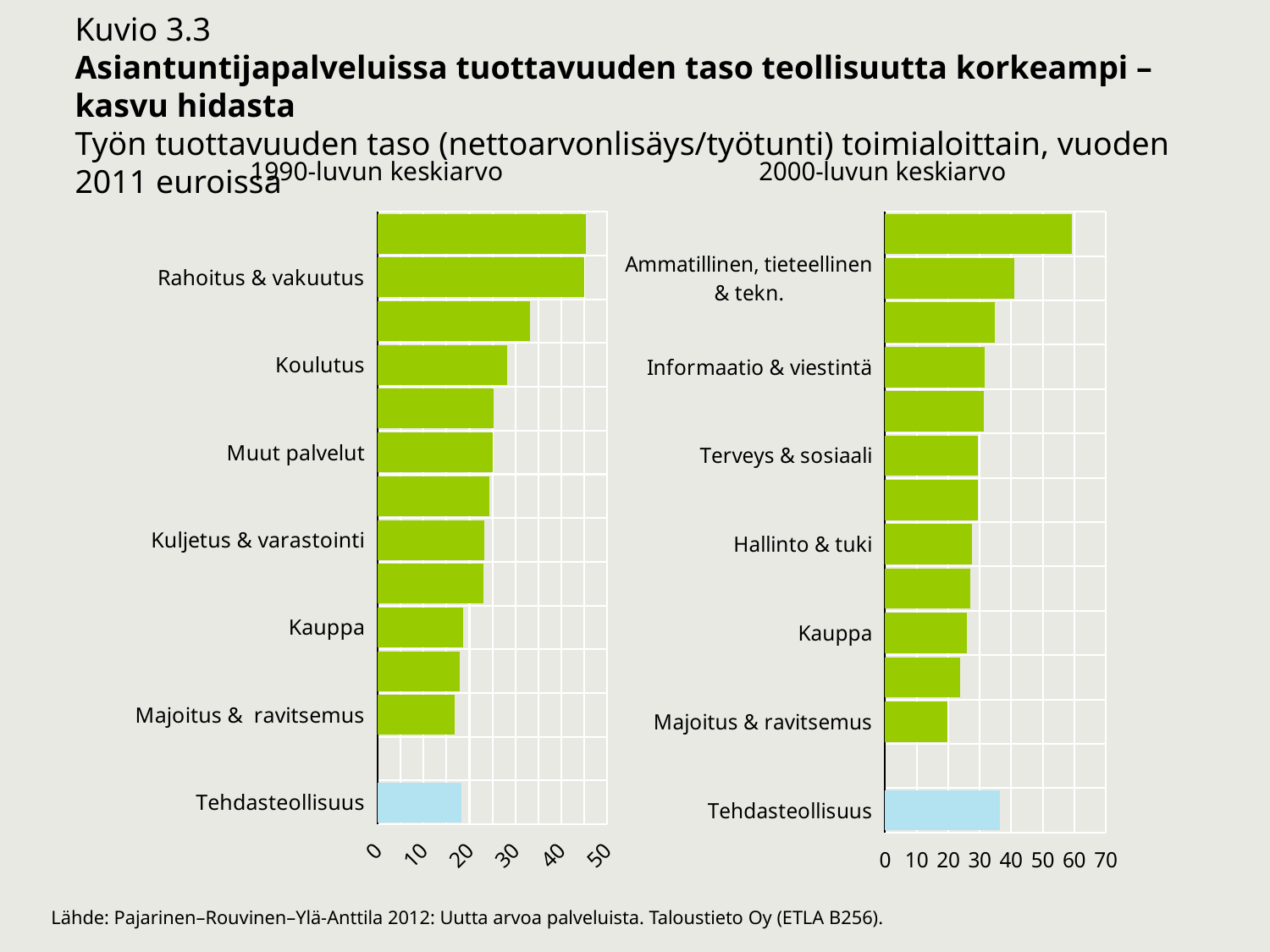
In the 2000-luvun keskiarvo chart, which is larger, Ammatillinen, tieteellinen & tekn. or Kauppa? Ammatillinen, tieteellinen & tekn. In the 1990-luvun keskiarvo chart, which is larger, Tehdasteollisuus or Rahoitus & vakuutus? Rahoitus & vakuutus In the 1990-luvun keskiarvo chart, is the value for Rahoitus & vakuutus greater or less than 40? greater In the 2000-luvun keskiarvo chart, is the value for Kauppa greater or less than 30? less In the 1990-luvun keskiarvo chart, is the value for Majoitus & ravitsemus greater or less than 20? less In the 2000-luvun keskiarvo chart, what colour is the Tehdasteollisuus bar? light blue In the 2000-luvun keskiarvo chart, which of the labelled categories has the lowest value? Majoitus & ravitsemus In the 1990-luvun keskiarvo chart, which is larger, Rahoitus & vakuutus or Koulutus? Rahoitus & vakuutus What kind of chart is the 1990-luvun keskiarvo chart? bar chart